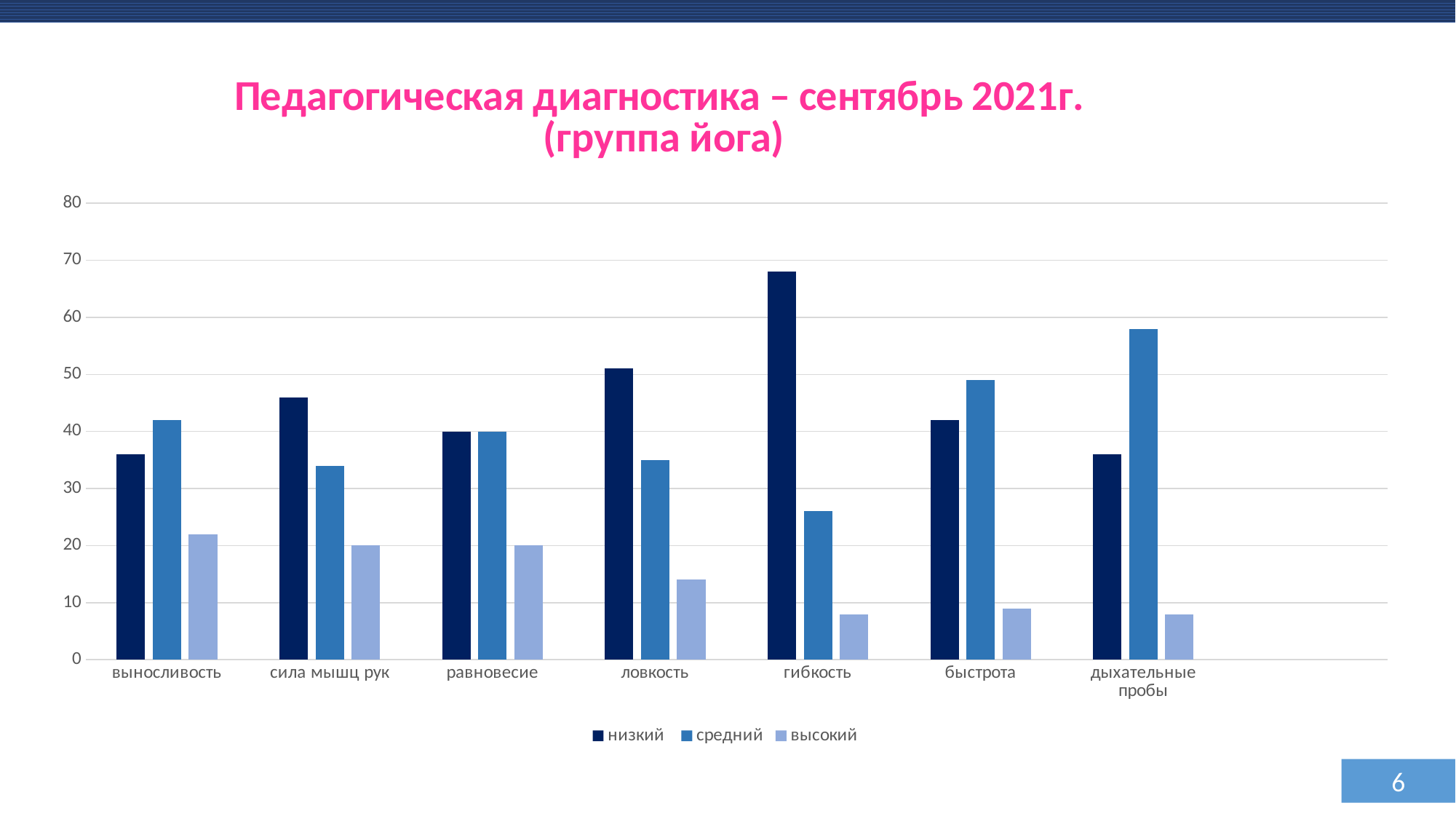
How many categories are shown along the x axis of the chart? 7 In the category выносливость, which is larger: the value for низкий or the value for средний? средний Which category has the highest value for the series средний? дыхательные пробы What are the three series listed in the chart legend? низкий, средний, высокий Which category has the highest value for the series низкий? гибкость Is the value for средний in the category дыхательные пробы greater or less than 50? greater How many series does the chart legend list? 3 Is the value for высокий in the category ловкость greater or less than 20? less Which category has the lowest value for the series средний? гибкость Is the value for низкий in the category гибкость greater or less than 60? greater What kind of chart is shown on the slide? bar chart In the category сила мышц рук, which is larger: the value for низкий or the value for средний? низкий